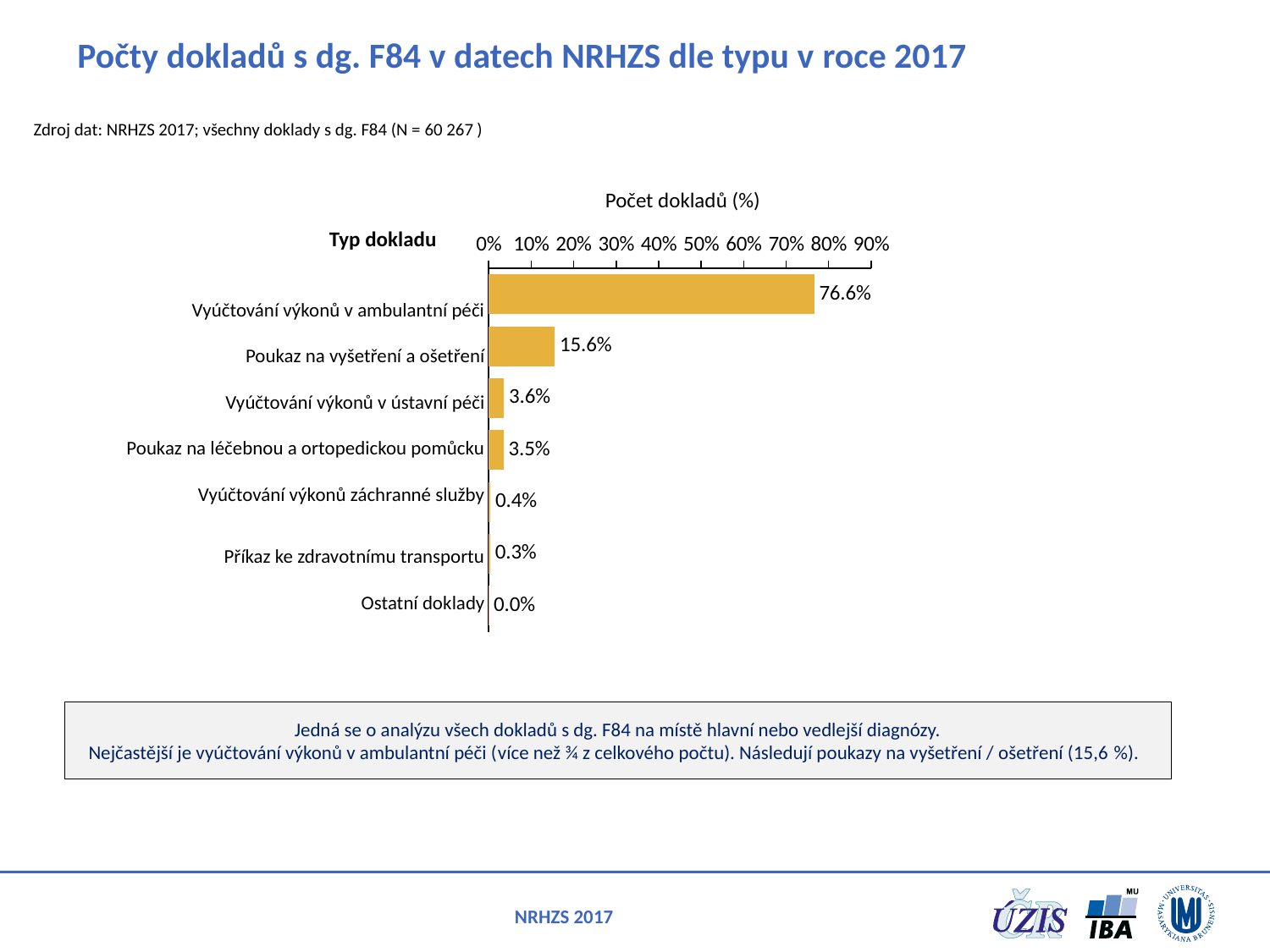
What is the value for Poukaz na vyšetření a ošetření? 15.6% What is the value for Příkaz ke zdravotnímu transportu? 0.3% Is the value for Vyúčtování výkonů v ambulantní péči greater or less than 70%? greater What is the value for Vyúčtování výkonů v ambulantní péči? 76.6% How many document types are shown in the chart? 7 Which document type has the highest share? Vyúčtování výkonů v ambulantní péči What is the value for Poukaz na léčebnou a ortopedickou pomůcku? 3.5% Which document type has the lowest share? Ostatní doklady What is the difference between Vyúčtování výkonů v ambulantní péči and Poukaz na vyšetření a ošetření? 61.0% What kind of chart is shown on the slide? bar chart Which is larger: Vyúčtování výkonů v ústavní péči or Vyúčtování výkonů záchranné služby? Vyúčtování výkonů v ústavní péči What is the label of the horizontal axis of the chart? Počet dokladů (%)